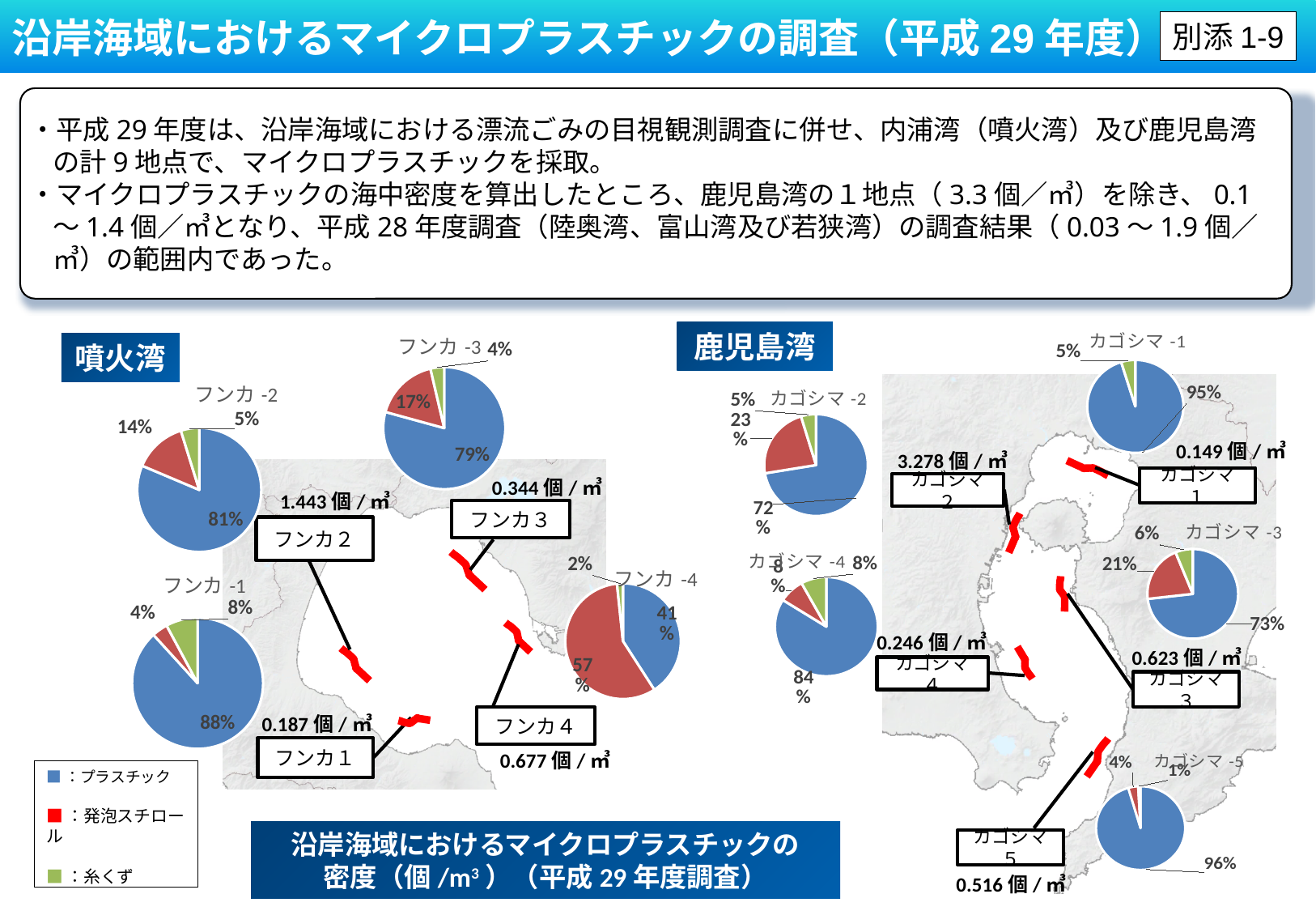
In the フンカ-3 pie chart, what share is labelled for the red 発泡スチロール slice? 17% In the フンカ-4 pie chart, which slice is the largest? 発泡スチロール In the フンカ-4 pie chart, what share is labelled for the red 発泡スチロール slice? 57% Which is larger: the 発泡スチロール share in the カゴシマ-2 pie chart or in the カゴシマ-4 pie chart? カゴシマ-2 In the カゴシマ-2 pie chart, what share is labelled for the blue プラスチック slice? 72% According to the legend, which colour represents 糸くず? Green In the カゴシマ-3 pie chart, which slice is the smallest? 糸くず In the フンカ-1 pie chart, what share is labelled for the blue プラスチック slice? 88% In the カゴシマ-5 pie chart, what share is labelled for the blue プラスチック slice? 96% In the フンカ-2 pie chart, what is the difference between the プラスチック share and the 発泡スチロール share? 67% How many categories does the legend at the bottom left list? 3 What kind of chart is used for フンカ-1? Pie chart